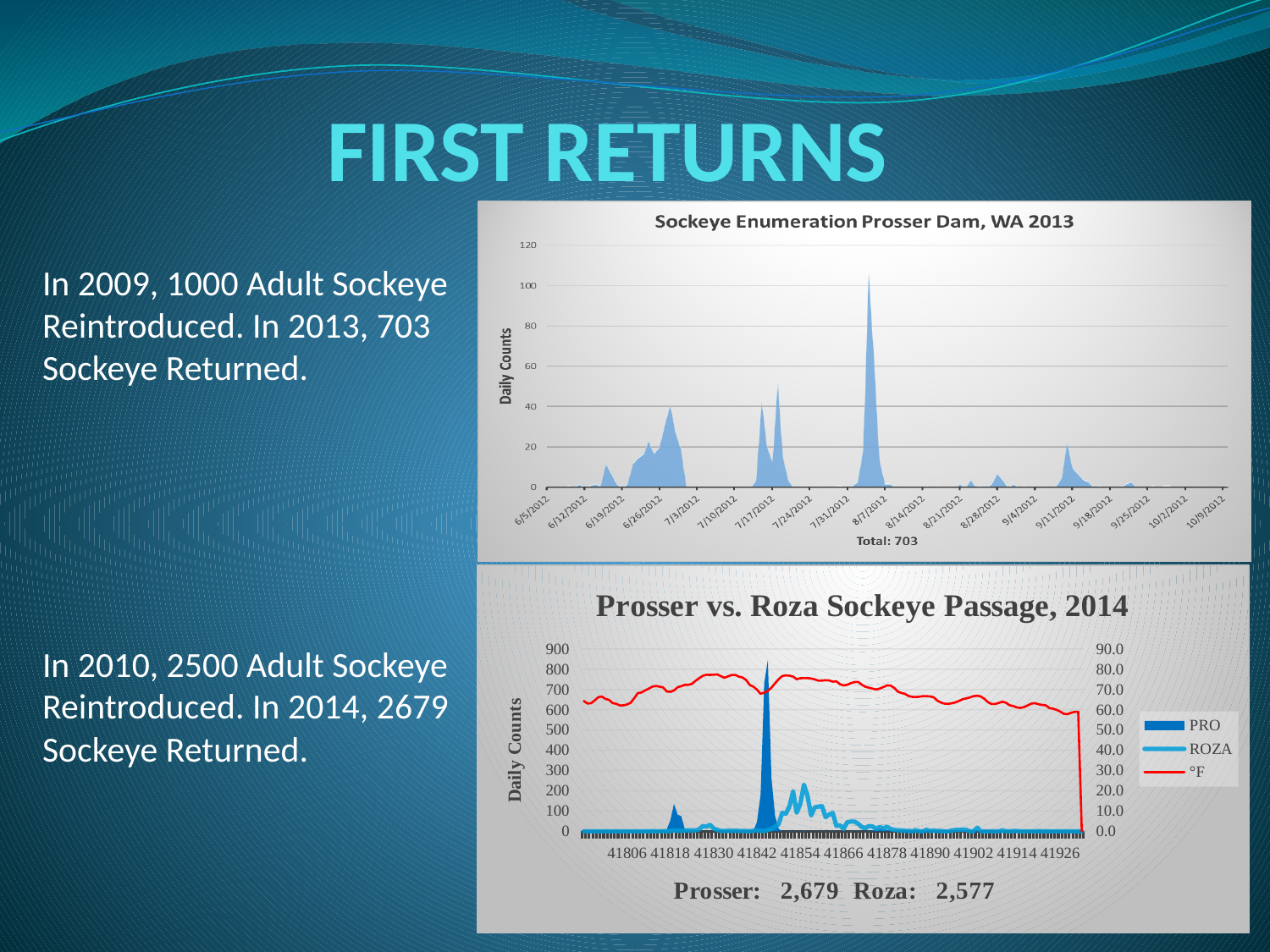
What kind of chart is the top chart, Sockeye Enumeration Prosser Dam, WA 2013? area chart In the bottom chart, Prosser vs. Roza Sockeye Passage, 2014, what is the printed total for Roza? 2,577 What is the maximum value shown on the y axis of the top chart, Sockeye Enumeration Prosser Dam, WA 2013? 120 In the bottom chart, Prosser vs. Roza Sockeye Passage, 2014, what is the printed total for Prosser? 2,679 In the bottom chart, Prosser vs. Roza Sockeye Passage, 2014, which has the larger printed total, Prosser or Roza? Prosser How many series does the legend of the bottom chart, Prosser vs. Roza Sockeye Passage, 2014, list? 3 In the bottom chart, Prosser vs. Roza Sockeye Passage, 2014, does the °F line rise or fall over the last part of the x axis (from about 41866 to 41926)? fall What is the title of the top chart on the slide? Sockeye Enumeration Prosser Dam, WA 2013 In the top chart, Sockeye Enumeration Prosser Dam, WA 2013, is the highest daily count peak greater or less than 80? greater In the bottom chart, Prosser vs. Roza Sockeye Passage, 2014, is the highest PRO daily count peak greater or less than 700? greater What total is printed below the top chart, Sockeye Enumeration Prosser Dam, WA 2013? Total: 703 In the bottom chart, Prosser vs. Roza Sockeye Passage, 2014, what is the difference between the printed Prosser and Roza totals? 102